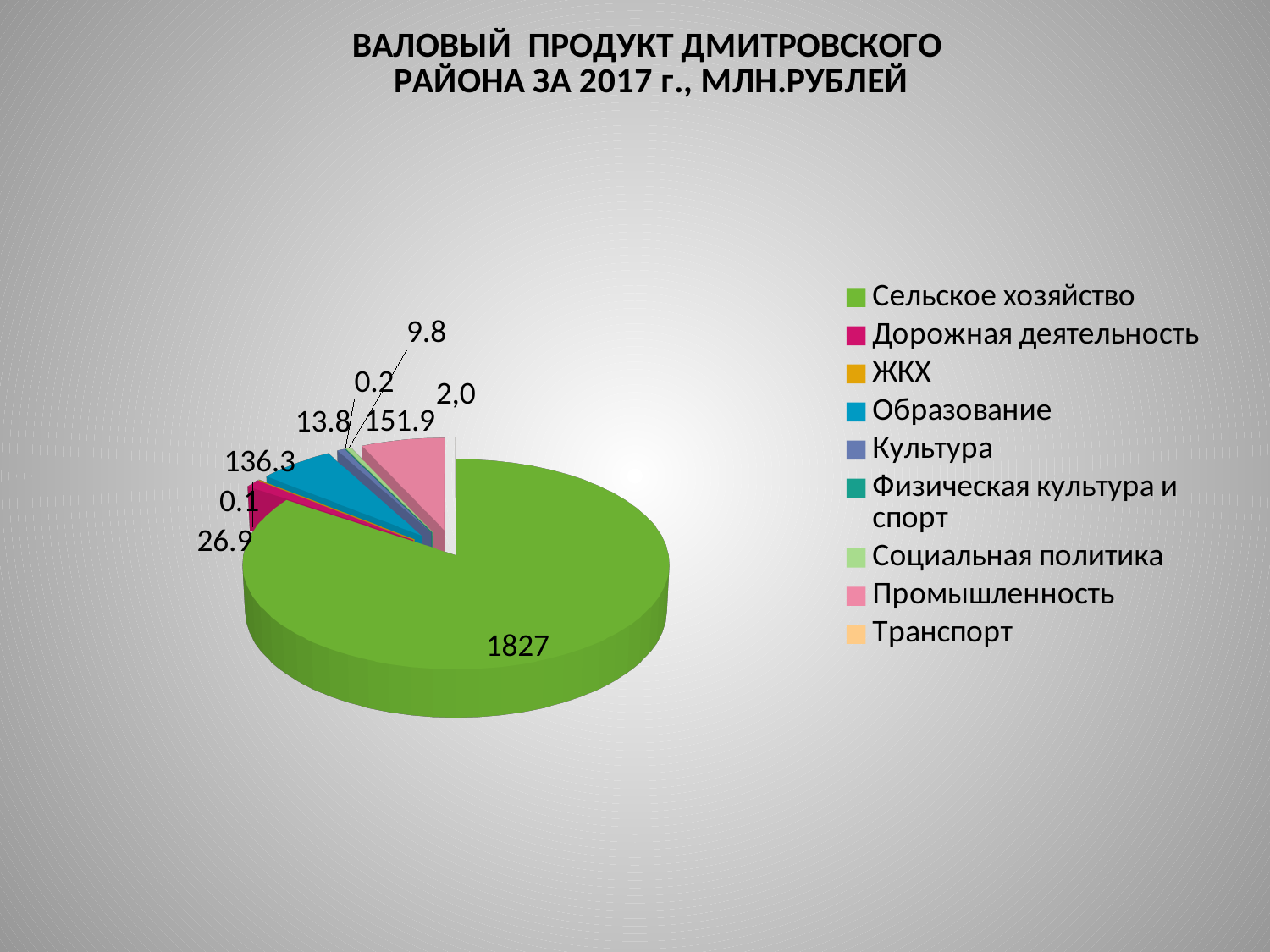
Which is larger, the value for Промышленность or the value for Образование? Промышленность What is the value for Образование? 136.3 Which category has the largest slice of the pie? Сельское хозяйство How many categories does the legend list? 9 What is the title of the chart? ВАЛОВЫЙ ПРОДУКТ ДМИТРОВСКОГО РАЙОНА ЗА 2017 г., МЛН.РУБЛЕЙ What type of chart is shown on the slide? Pie chart Which category has the smallest value according to the data labels? ЖКХ What is the value for Сельское хозяйство? 1827 What is the value for Промышленность? 151.9 What colour is the slice for Сельское хозяйство? Green What is the value for Дорожная деятельность? 26.9 What is the difference between the values for Промышленность and Образование? 15.6